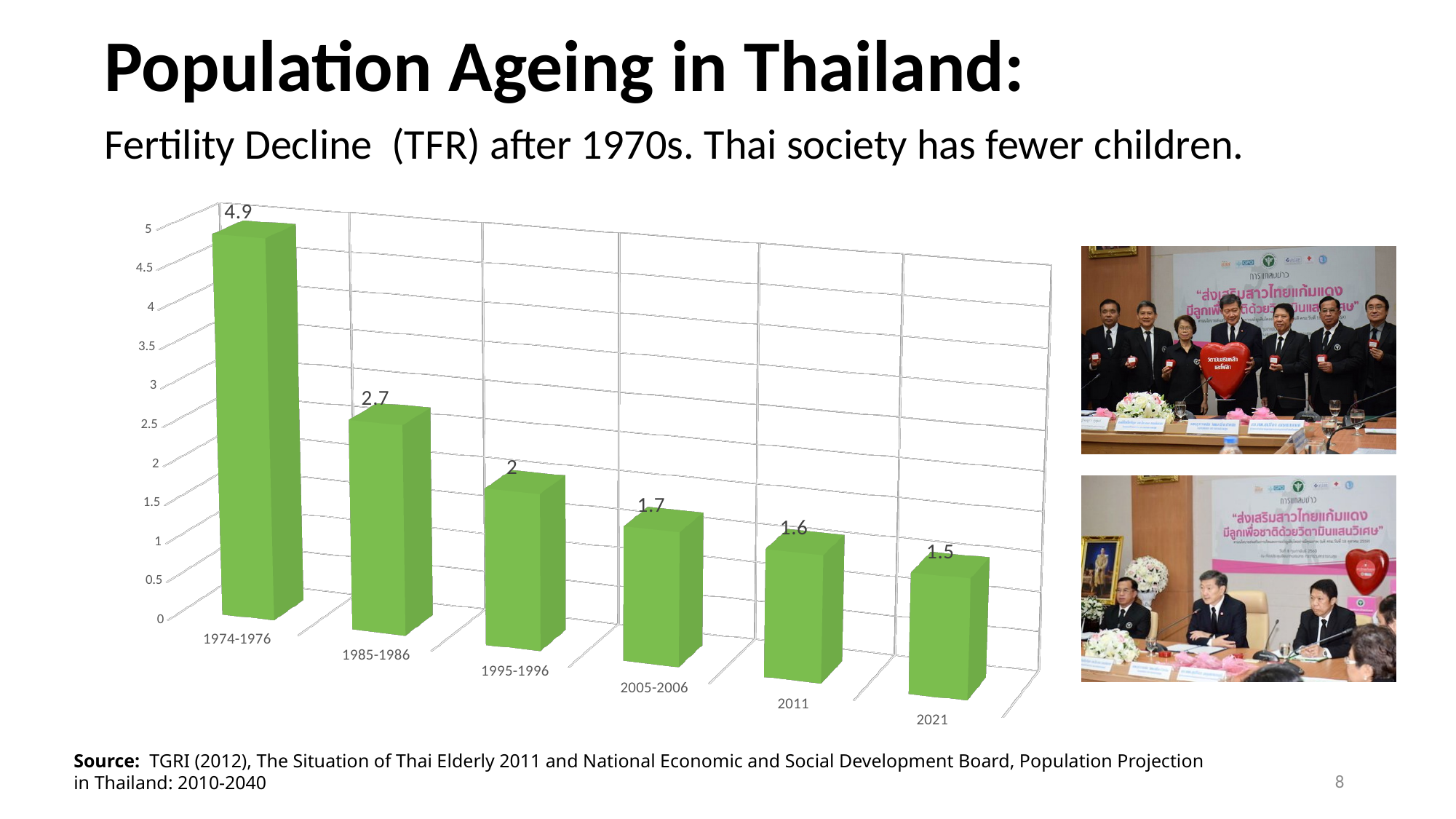
What is the difference between the TFR values for 1995-1996 and 2011? 0.4 What is the difference between the TFR values for 1974-1976 and 1985-1986? 2.2 Do the TFR values rise or fall from 1974-1976 to 2021? Fall How many periods are shown on the x axis of the chart? 6 What kind of chart is shown on the slide? Bar chart What is the TFR value shown for 2021? 1.5 What is the TFR value shown for 2005-2006? 1.7 What is the TFR value shown for 1985-1986? 2.7 Which period has the highest TFR value? 1974-1976 Which period has the lowest TFR value? 2021 What is the TFR value shown for 1974-1976? 4.9 Which is larger, the TFR value for 1985-1986 or for 1995-1996? 1985-1986